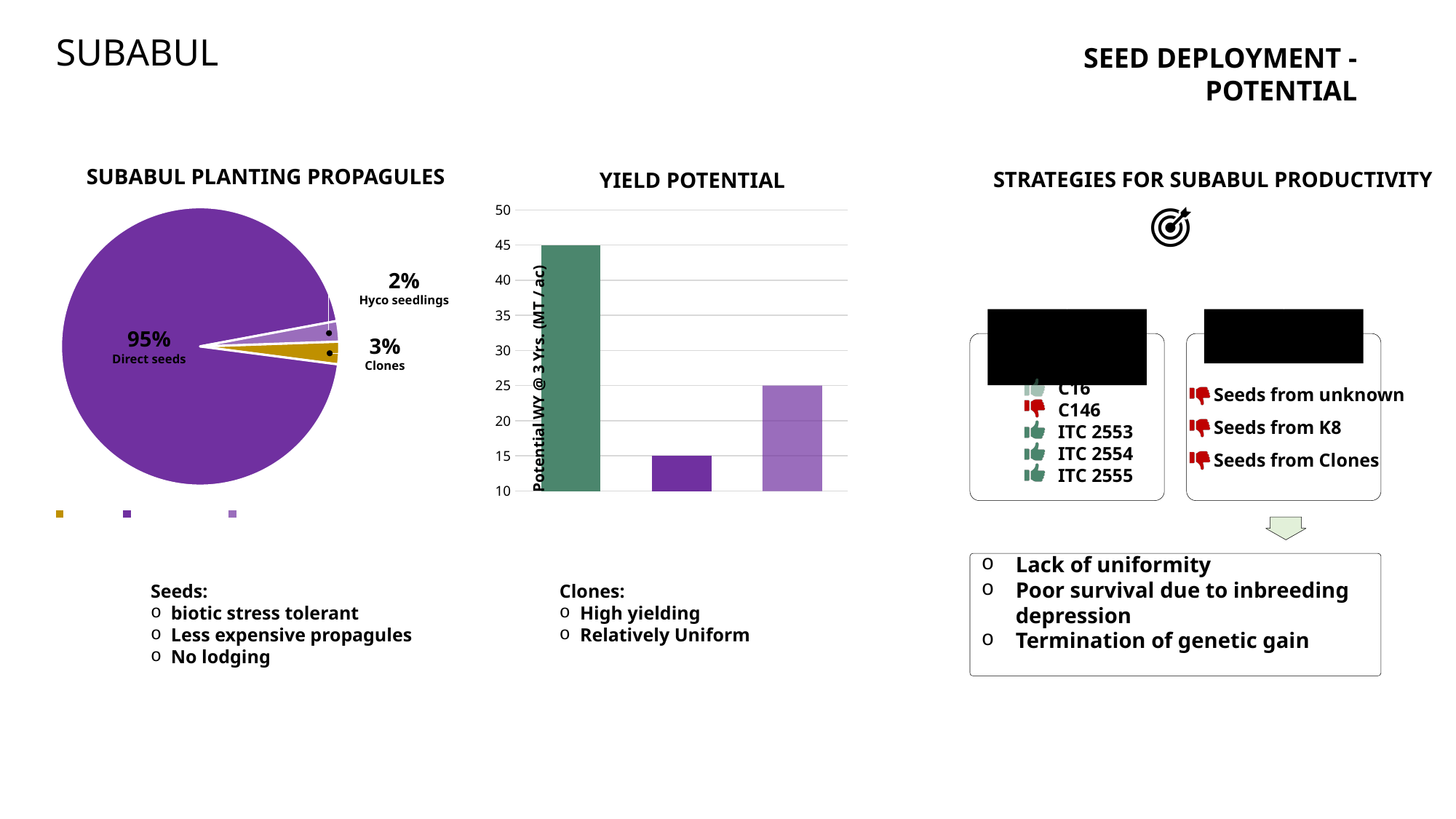
What kind of chart is SUBABUL PLANTING PROPAGULES? Pie chart In the SUBABUL PLANTING PROPAGULES pie chart, what is the difference in percentage points between Clones and Hyco seedlings? 1% In the SUBABUL PLANTING PROPAGULES pie chart, what share is labelled for Hyco seedlings? 2% In the SUBABUL PLANTING PROPAGULES pie chart, which category has the largest slice? Direct seeds In the YIELD POTENTIAL chart, how many bars are plotted? 3 In the SUBABUL PLANTING PROPAGULES pie chart, what share is labelled for Clones? 3% In the SUBABUL PLANTING PROPAGULES pie chart, what share is labelled for Direct seeds? 95% In the SUBABUL PLANTING PROPAGULES pie chart, which category has the smallest slice? Hyco seedlings In the YIELD POTENTIAL chart, what is the label on the vertical axis? Potential WY @ 3 Yrs. (MT / ac) What kind of chart is YIELD POTENTIAL? Bar chart In the YIELD POTENTIAL chart, is the value of the leftmost (green) bar greater or less than 40? greater In the SUBABUL PLANTING PROPAGULES pie chart, how many slices are there? 3